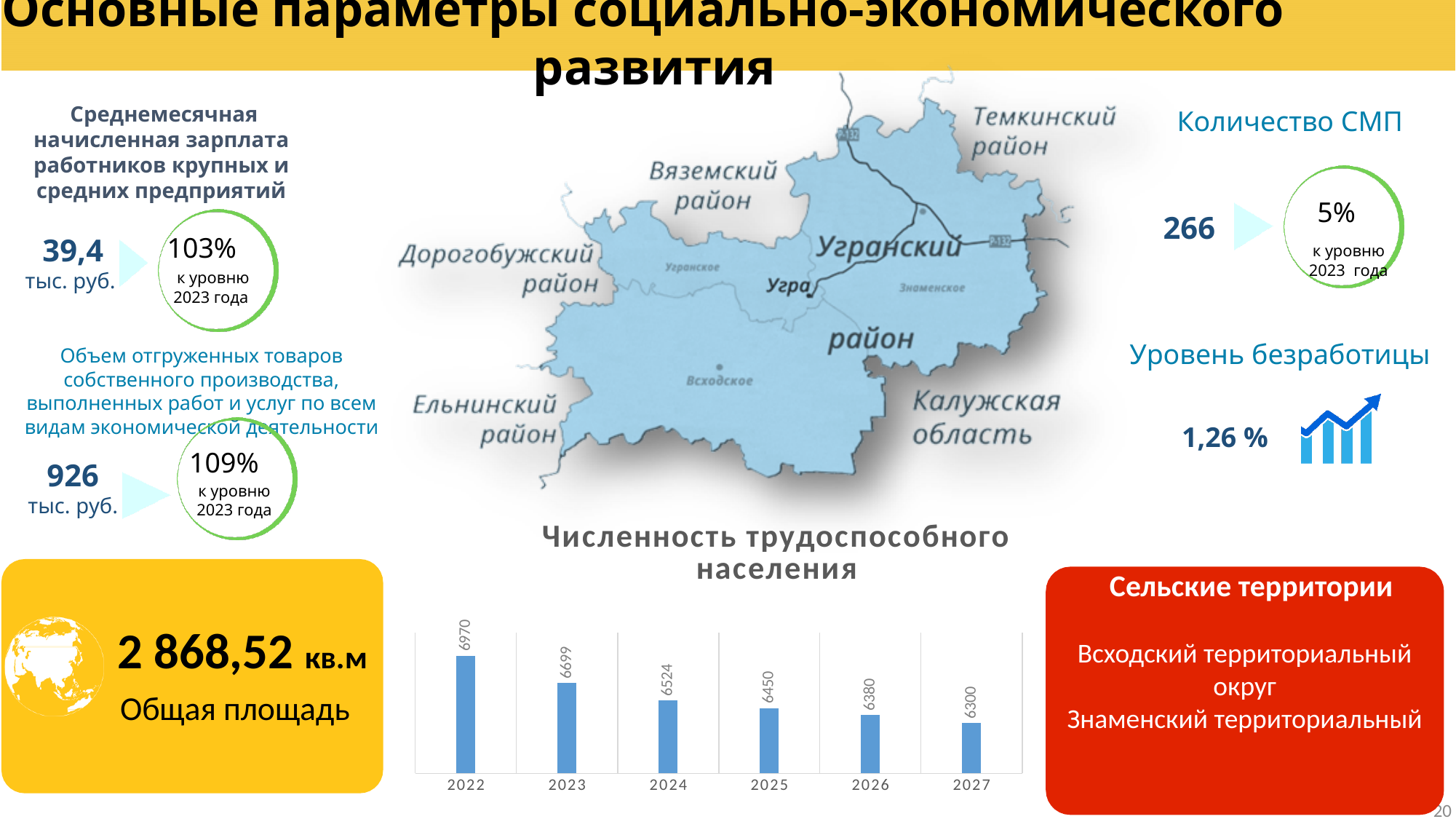
Which year has the lowest value in the chart 'Численность трудоспособного населения'? 2027 What is the value for 2027 in the chart 'Численность трудоспособного населения'? 6300 Do the values in the chart 'Численность трудоспособного населения' rise or fall from 2022 to 2027? fall What kind of chart is 'Численность трудоспособного населения'? bar chart What is the title of the bar chart at the bottom centre of the slide? Численность трудоспособного населения What is the value for 2025 in the chart 'Численность трудоспособного населения'? 6450 In the chart 'Численность трудоспособного населения', which is larger: the value for 2023 or the value for 2026? 2023 What is the difference between the values for 2024 and 2027 in the chart 'Численность трудоспособного населения'? 224 Which year has the highest value in the chart 'Численность трудоспособного населения'? 2022 How many years are shown in the chart 'Численность трудоспособного населения'? 6 What is the difference between the values for 2022 and 2023 in the chart 'Численность трудоспособного населения'? 271 What is the value for 2022 in the chart 'Численность трудоспособного населения'? 6970